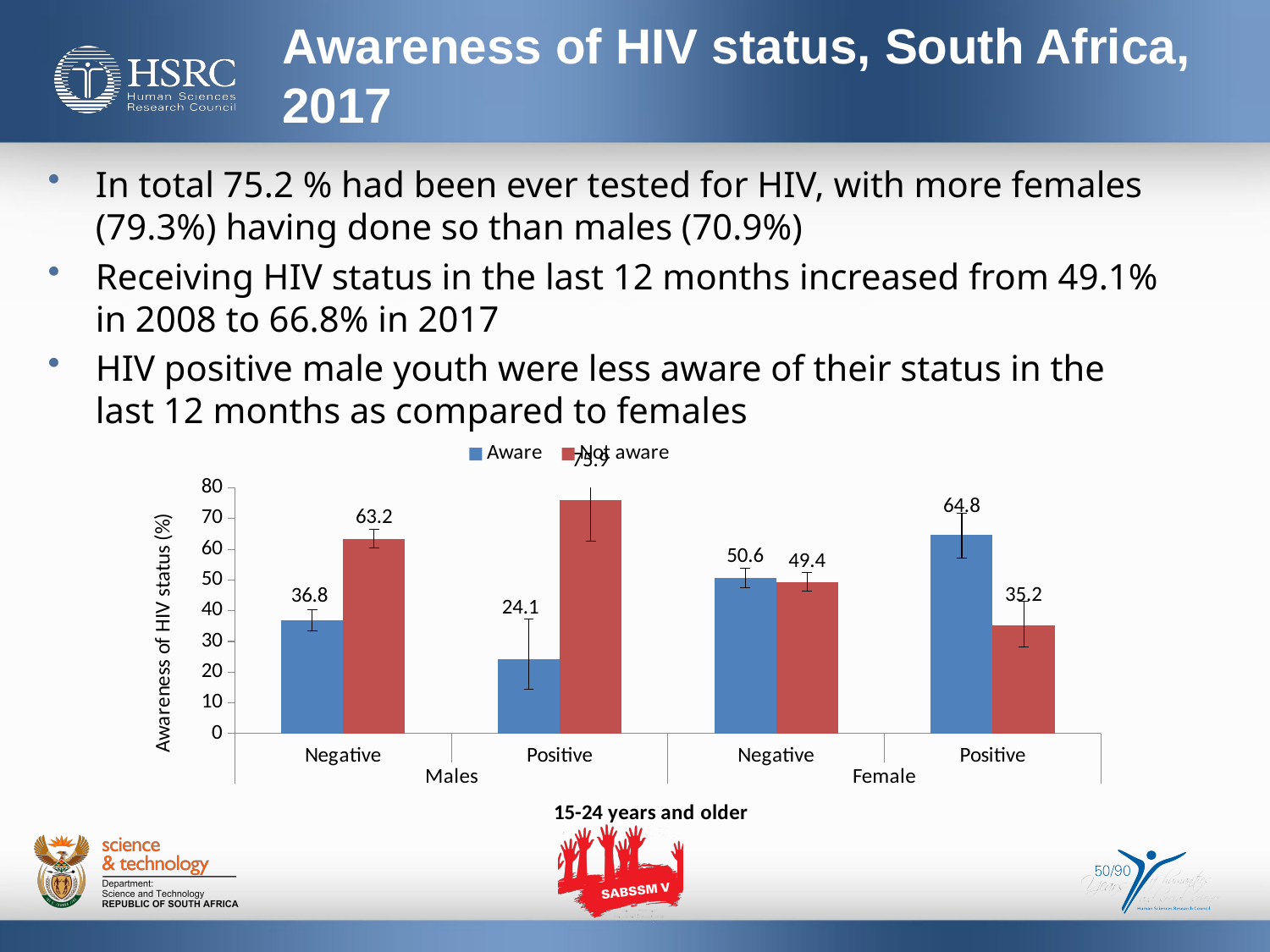
What is the difference between the Aware values for HIV-positive females and HIV-positive males? 40.7 What kind of chart is shown on the slide? Bar chart Which is larger for HIV-negative females: the Aware value or the Not aware value? Aware How many series does the chart legend list? 2 Is the Not aware value for HIV-positive males greater or less than 70? greater What is the Aware value for HIV-positive males? 24.1 What is the Aware value for HIV-negative males? 36.8 Which group has the lowest Aware value? Positive males What is the Not aware value for HIV-positive females? 35.2 Which group has the highest Aware value? Positive females What is the Not aware value for HIV-negative males? 63.2 What is the Aware value for HIV-positive females? 64.8